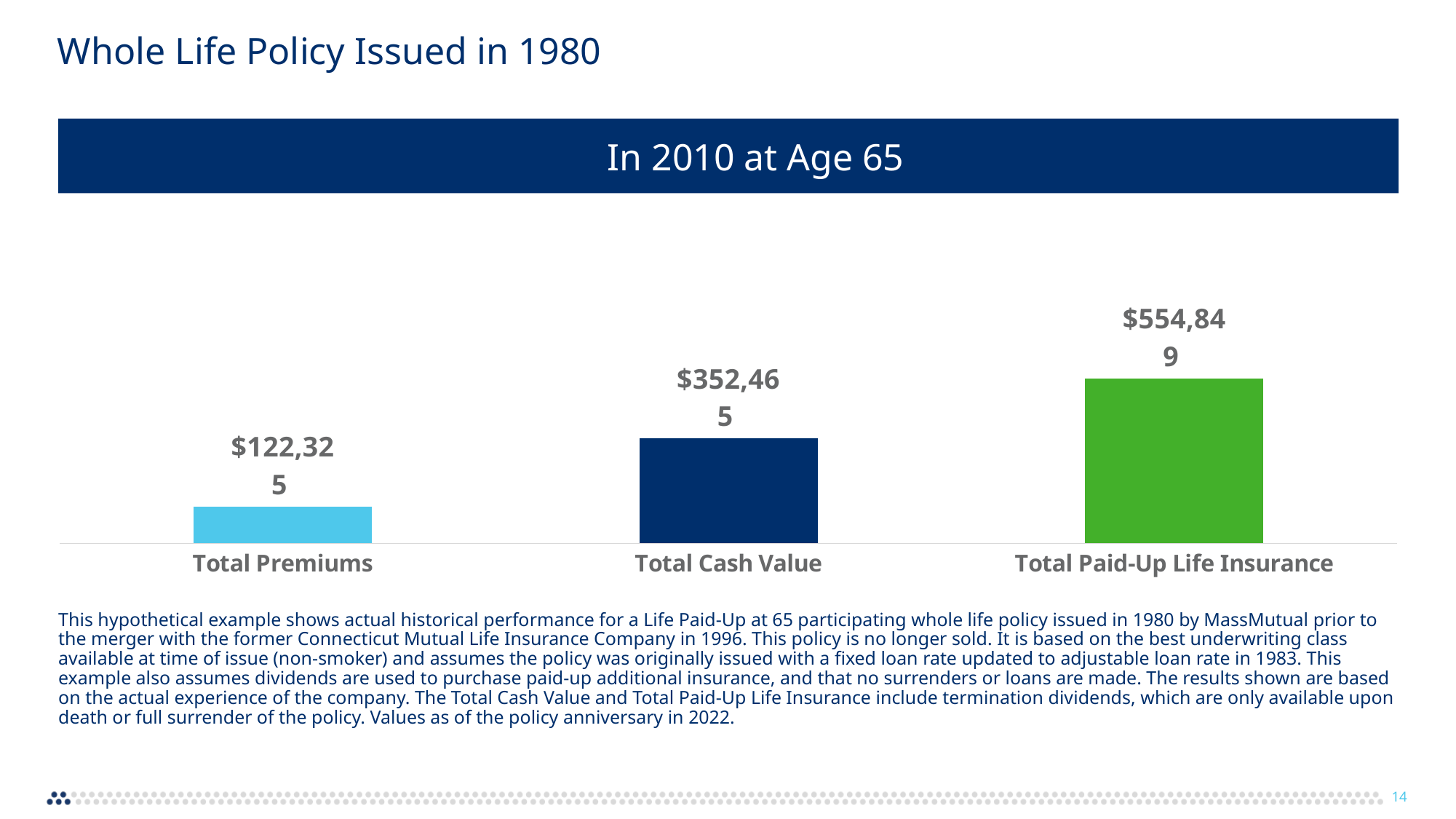
What is the value for Total Paid-Up Life Insurance? $554,849 What is the difference between Total Paid-Up Life Insurance and Total Premiums? $432,524 Which is larger, Total Cash Value or Total Premiums? Total Cash Value How many categories are shown in the chart? 3 Which category has the lowest value? Total Premiums What is the value for Total Cash Value? $352,465 What is the difference between Total Cash Value and Total Premiums? $230,140 What is the value for Total Premiums? $122,325 What is the difference between Total Paid-Up Life Insurance and Total Cash Value? $202,384 Which category has the highest value? Total Paid-Up Life Insurance What colour is the bar for Total Paid-Up Life Insurance? Green What kind of chart is shown on the slide? Bar chart